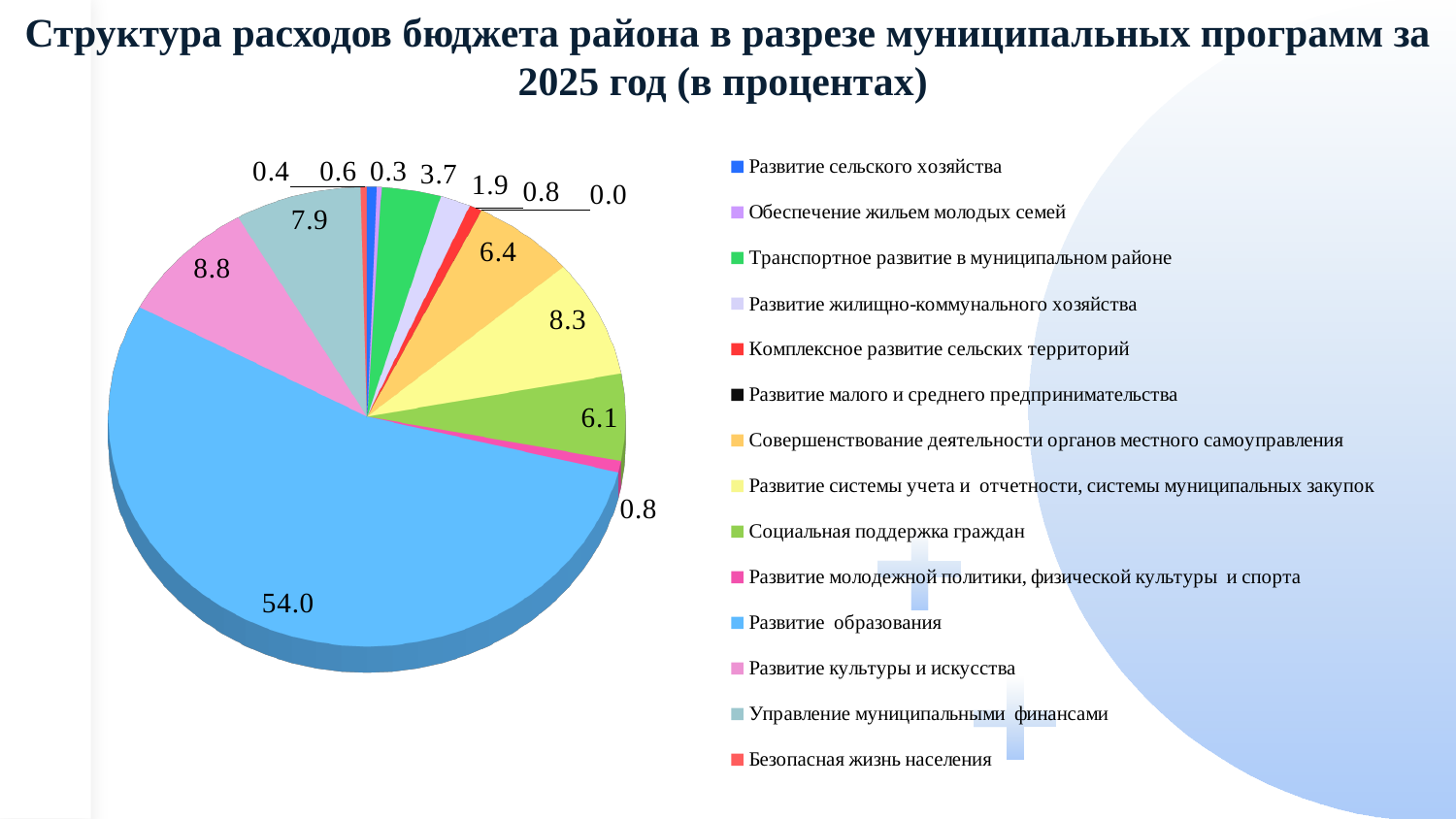
What is the title of the chart on the slide? Структура расходов бюджета района в разрезе муниципальных программ за 2025 год (в процентах) What is the difference between the values for Развитие образования and Развитие культуры и искусства? 45.2 What is the value for Совершенствование деятельности органов местного самоуправления? 6.4 How many entries does the legend list? 14 Which program has the largest share of the budget expenditures? Развитие образования Which is larger: the value for Развитие системы учета и отчетности, системы муниципальных закупок or the value for Совершенствование деятельности органов местного самоуправления? Развитие системы учета и отчетности, системы муниципальных закупок What is the value for Управление муниципальными финансами? 7.9 What is the value for Развитие культуры и искусства? 8.8 What is the value for Развитие системы учета и отчетности, системы муниципальных закупок? 8.3 What is the value for Социальная поддержка граждан? 6.1 What kind of chart is shown on the slide? pie chart What is the value for Развитие образования? 54.0